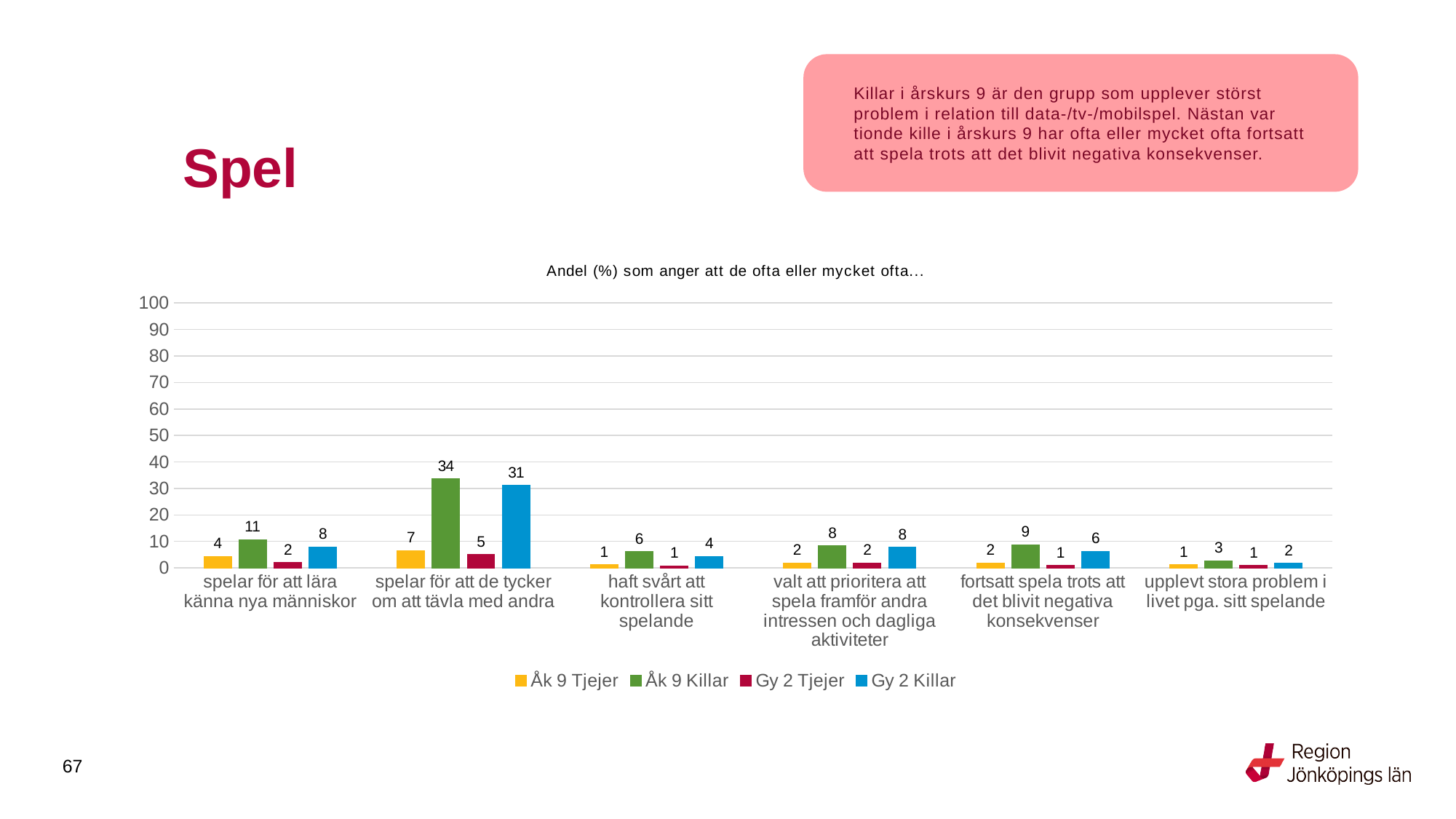
How many series does the legend list? 4 What kind of chart is shown on the slide? bar chart What is the value for Gy 2 Killar in the category 'fortsatt spela trots att det blivit negativa konsekvenser'? 6 Is the value for Åk 9 Killar in 'spelar för att de tycker om att tävla med andra' greater or less than 30? greater What is the value for Åk 9 Killar in the category 'spelar för att de tycker om att tävla med andra'? 34 What is the difference between Åk 9 Killar and Gy 2 Killar in the category 'spelar för att de tycker om att tävla med andra'? 3 Which category has the highest value for Åk 9 Killar? spelar för att de tycker om att tävla med andra Which series has the lowest value in the category 'haft svårt att kontrollera sitt spelande'? Åk 9 Tjejer and Gy 2 Tjejer (both 1) What is the title of the chart? Andel (%) som anger att de ofta eller mycket ofta... Which is larger in the category 'spelar för att lära känna nya människor': Åk 9 Killar or Gy 2 Killar? Åk 9 Killar What is the value for Åk 9 Tjejer in the category 'spelar för att lära känna nya människor'? 4 How many categories are shown on the x axis? 6